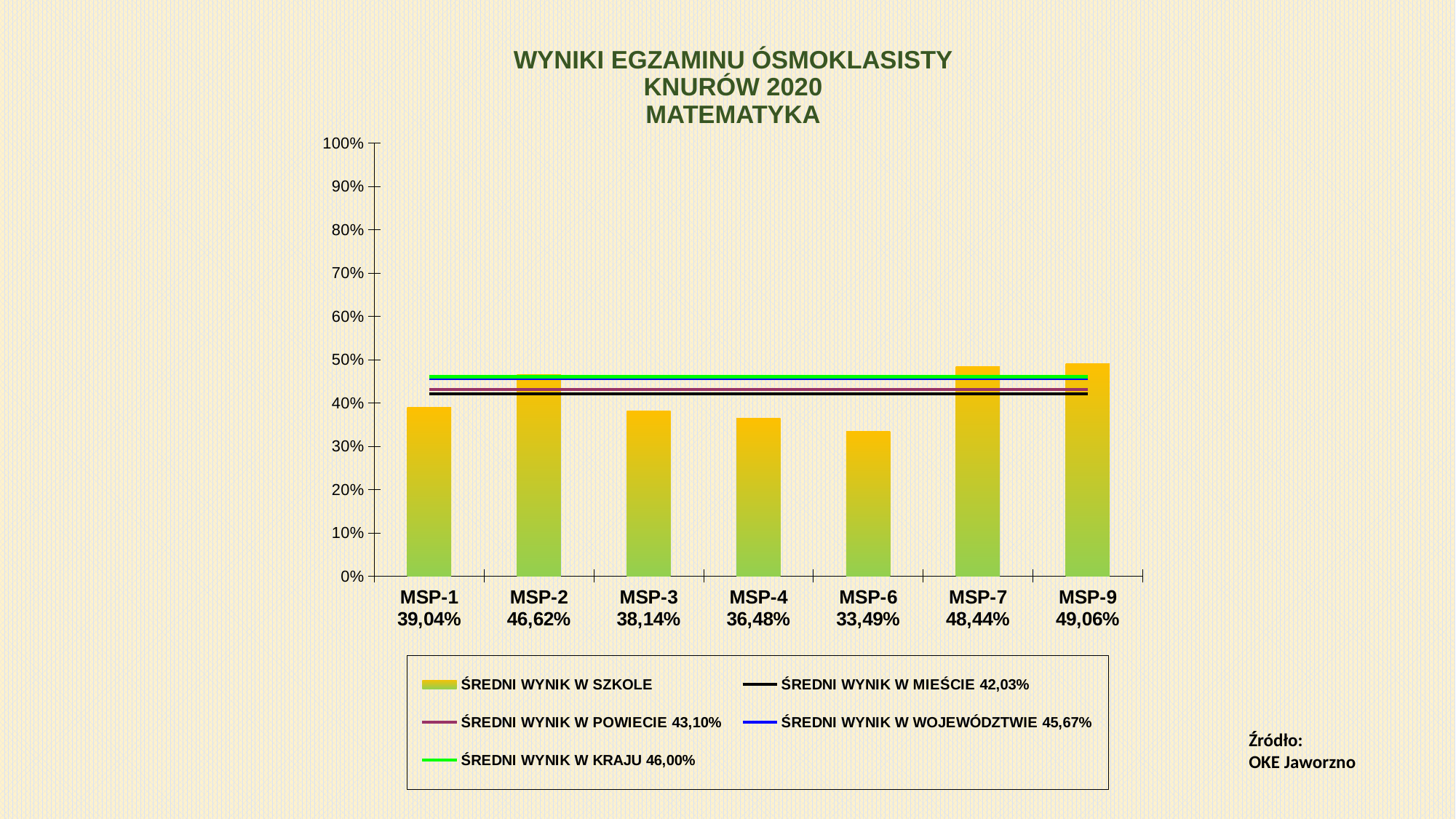
Is the value for MSP-4 greater or less than 40%? less What is the difference between the scores of MSP-7 and MSP-1? 9,40 percentage points What kind of chart is shown on the slide? combination bar and line chart What is the difference between the scores of MSP-9 and MSP-6? 15,57 percentage points Which school has the highest average score? MSP-9 Which school has the lowest average score? MSP-6 What is the value shown in the legend for ŚREDNI WYNIK W KRAJU? 46,00% What is the average score for MSP-9? 49,06% How many schools are shown on the x axis? 7 How many series does the legend list? 5 What is the average score for MSP-4? 36,48% Which school has a higher score, MSP-2 or MSP-3? MSP-2